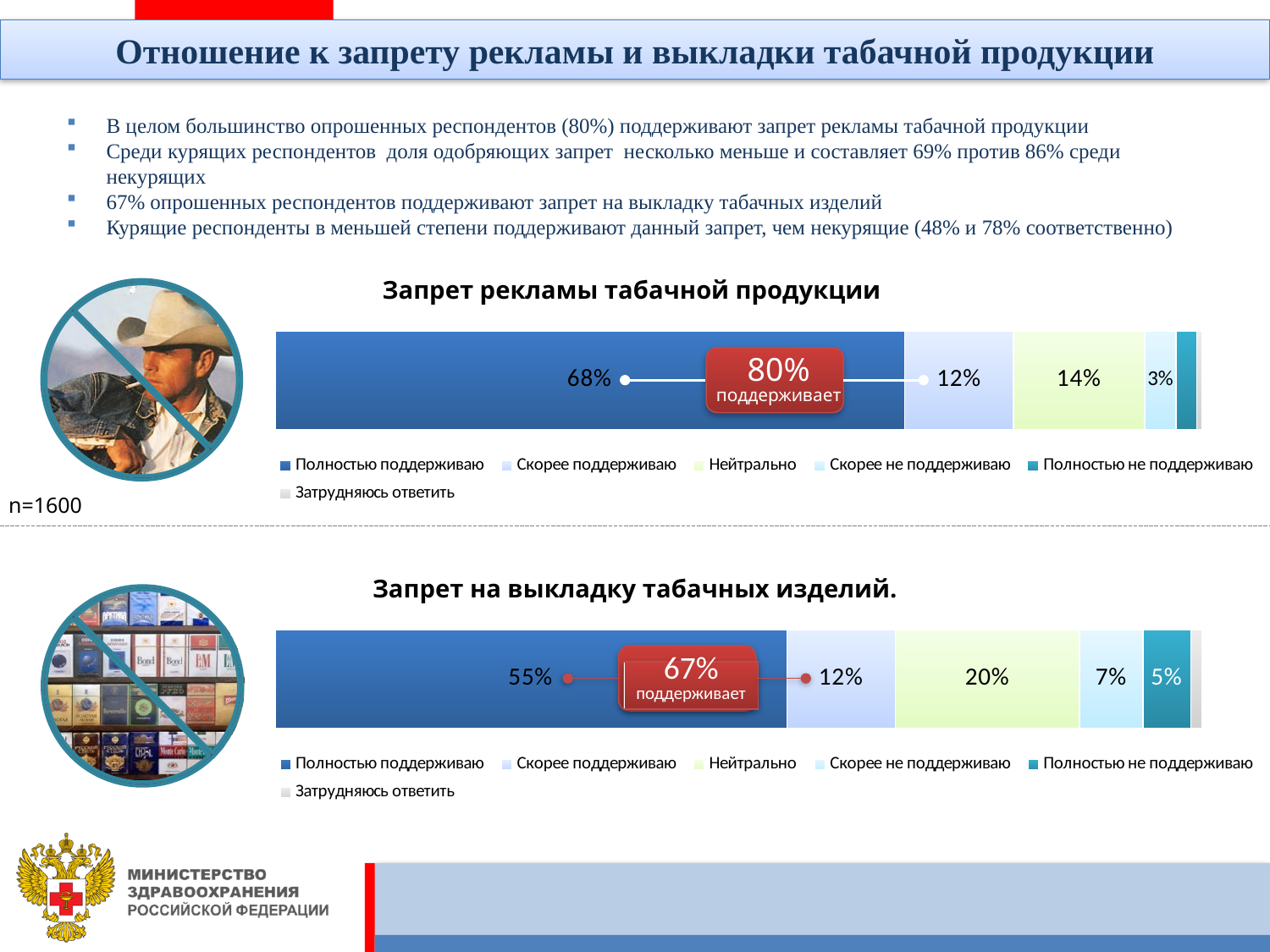
In the chart titled "Запрет рекламы табачной продукции", what is the difference between "Полностью поддерживаю" and "Скорее поддерживаю"? 56% In the chart titled "Запрет на выкладку табачных изделий.", what is the value for "Полностью не поддерживаю"? 5% In the chart titled "Запрет на выкладку табачных изделий.", which segment is the largest? Полностью поддерживаю In the chart titled "Запрет рекламы табачной продукции", what is the value for "Полностью поддерживаю"? 68% How many series does the legend of the chart titled "Запрет рекламы табачной продукции" list? 6 What kind of chart is the chart titled "Запрет на выкладку табачных изделий."? Stacked bar chart In the chart titled "Запрет рекламы табачной продукции", what is the value for "Нейтрально"? 14% In the chart titled "Запрет рекламы табачной продукции", what is the value for "Скорее не поддерживаю"? 3% In the chart titled "Запрет на выкладку табачных изделий.", what is the value for "Полностью поддерживаю"? 55% In the chart titled "Запрет на выкладку табачных изделий.", what is the value for "Нейтрально"? 20% In the chart titled "Запрет на выкладку табачных изделий.", what is the difference between "Нейтрально" and "Скорее не поддерживаю"? 13% Which is larger: "Полностью поддерживаю" in the chart "Запрет рекламы табачной продукции" or "Полностью поддерживаю" in the chart "Запрет на выкладку табачных изделий."? Запрет рекламы табачной продукции